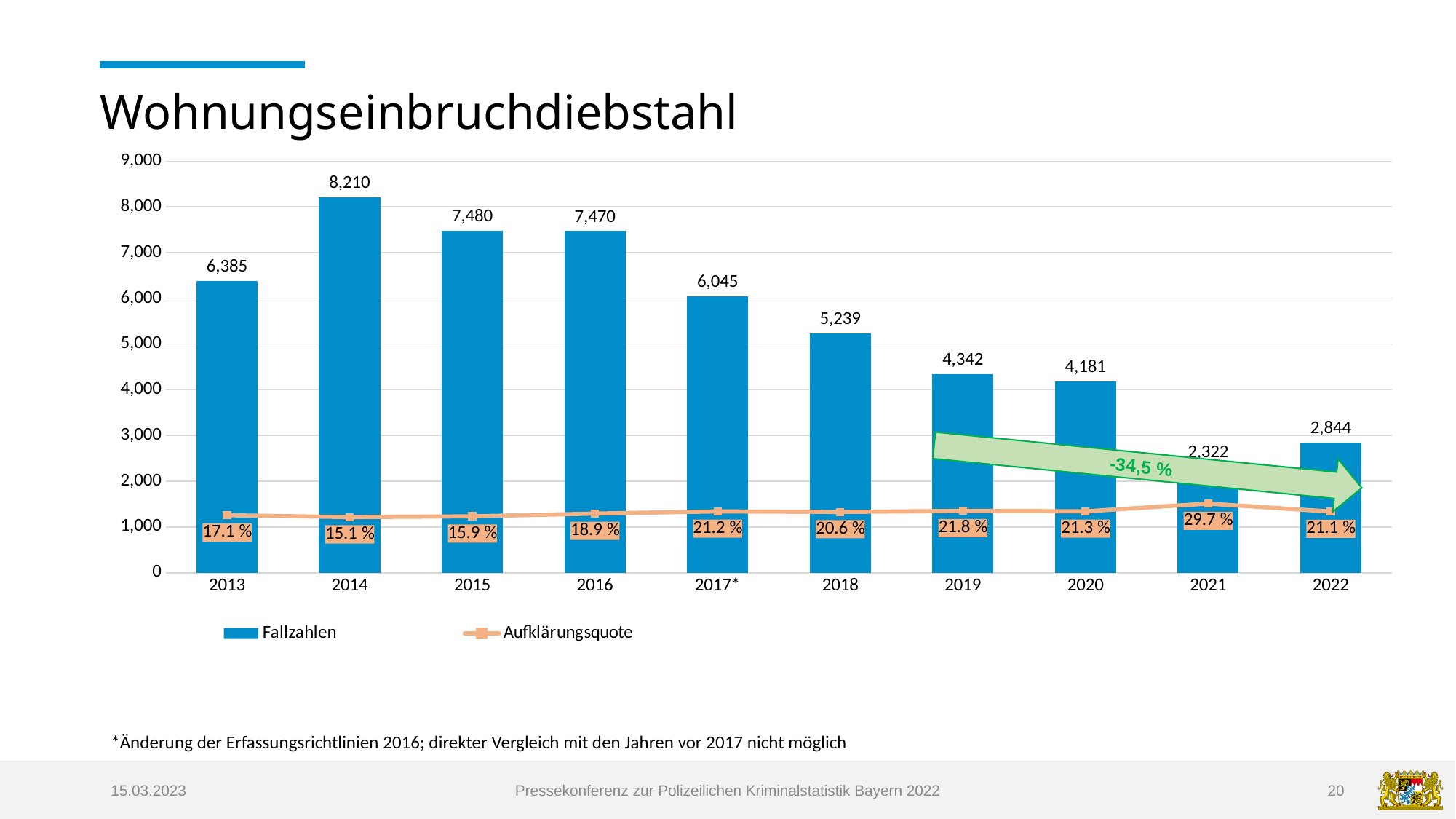
How many years are shown on the x axis? 10 Which year has the lowest Fallzahlen value? 2021 How many series does the legend list? 2 What is the Fallzahlen value for 2014? 8,210 What is the Aufklärungsquote for 2021? 29.7 % What kind of chart is used for the Fallzahlen series? bar chart Which year has the larger Fallzahlen value, 2019 or 2020? 2019 Do the Fallzahlen values generally rise or fall from 2014 to 2021? fall What is the title of the chart? Wohnungseinbruchdiebstahl Is the Fallzahlen value for 2018 greater or less than 5,000? greater Which year has the highest Fallzahlen value? 2014 What is the difference between the Fallzahlen values for 2013 and 2022? 3,541